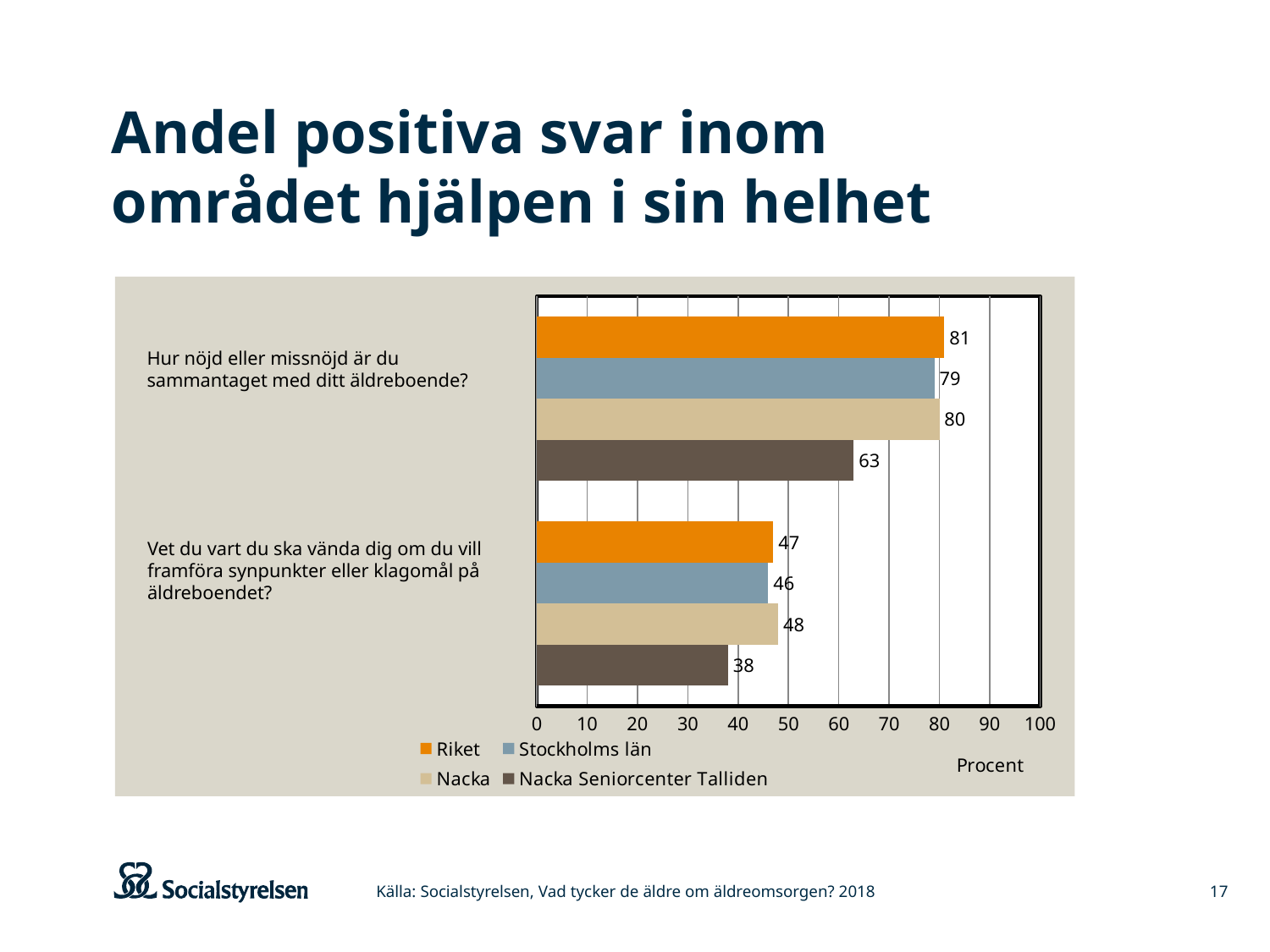
What is the value for Nacka on the question "Hur nöjd eller missnöjd är du sammantaget med ditt äldreboende?"? 80 Which is larger: the Riket value or the Nacka Seniorcenter Talliden value on the question "Vet du vart du ska vända dig om du vill framföra synpunkter eller klagomål på äldreboendet?"? Riket What is the value for Stockholms län on the question "Vet du vart du ska vända dig om du vill framföra synpunkter eller klagomål på äldreboendet?"? 46 What is the value for Nacka Seniorcenter Talliden on the question "Vet du vart du ska vända dig om du vill framföra synpunkter eller klagomål på äldreboendet?"? 38 What is the difference between the Riket value and the Nacka Seniorcenter Talliden value on the question "Hur nöjd eller missnöjd är du sammantaget med ditt äldreboende?"? 18 What is the value for Riket on the question "Hur nöjd eller missnöjd är du sammantaget med ditt äldreboende?"? 81 What is the difference between the Nacka value and the Nacka Seniorcenter Talliden value on the question "Vet du vart du ska vända dig om du vill framföra synpunkter eller klagomål på äldreboendet?"? 10 How many series does the legend list? 4 Which series has the highest value on the question "Vet du vart du ska vända dig om du vill framföra synpunkter eller klagomål på äldreboendet?"? Nacka What kind of chart is shown on the slide? Bar chart Which series has the lowest value on the question "Hur nöjd eller missnöjd är du sammantaget med ditt äldreboende?"? Nacka Seniorcenter Talliden What unit label is shown on the horizontal axis? Procent